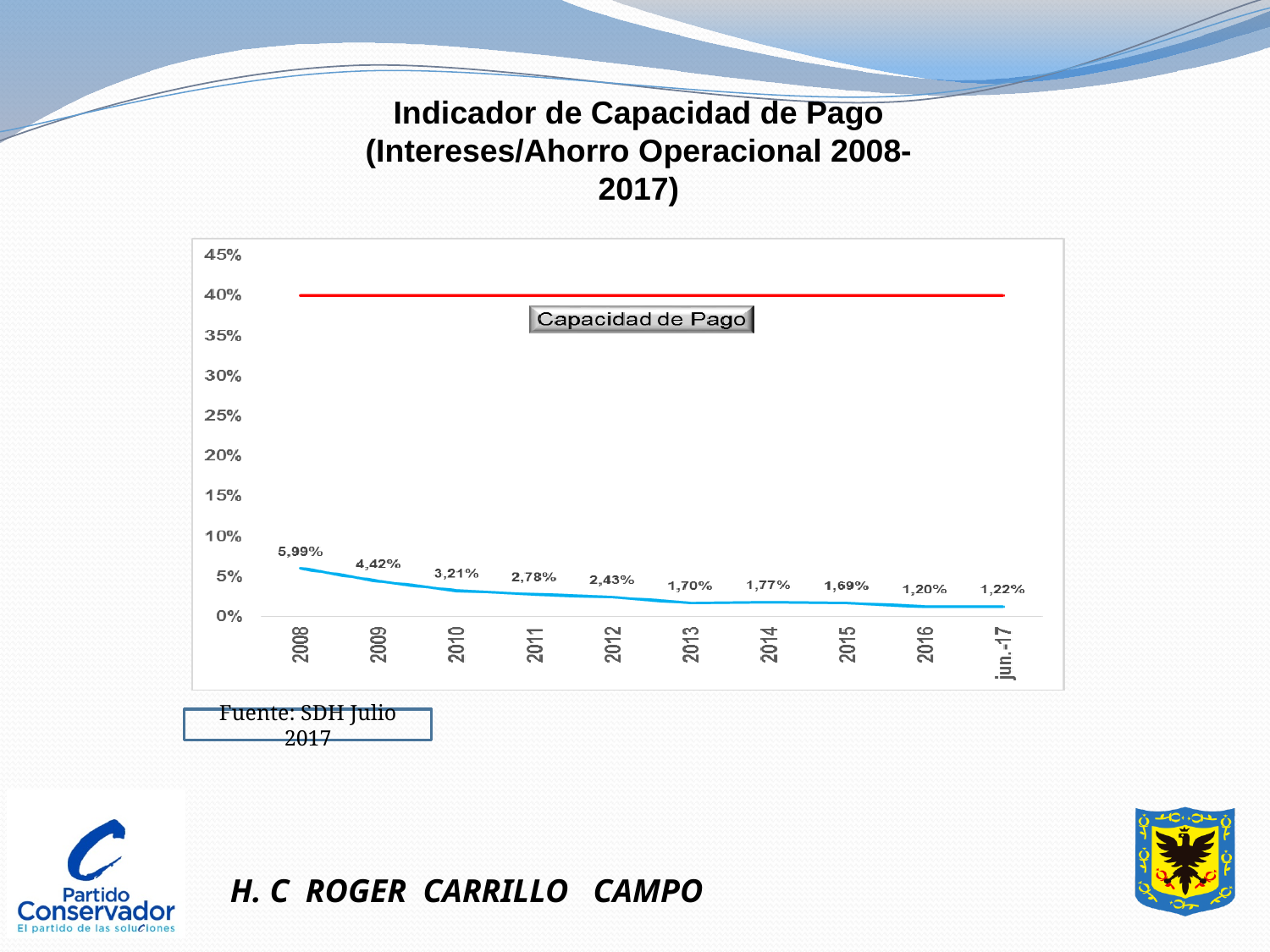
Do the Capacidad de Pago values generally rise or fall from 2008 to jun.-17? fall What is the Capacidad de Pago value for 2008? 5,99% Which year has the highest Capacidad de Pago value? 2008 Is the value for 2008 greater or less than 5%? greater At what level is the horizontal red line drawn on the chart? 40% What kind of chart is shown on the slide? line chart Which period has the lowest Capacidad de Pago value? 2016 What is the Capacidad de Pago value for jun.-17? 1,22% What is the difference between the 2008 value and the 2009 value? 1,57 percentage points How many data points are plotted on the Capacidad de Pago line? 10 Which is larger, the value for 2013 or the value for 2014? 2014 What is the Capacidad de Pago value for 2012? 2,43%